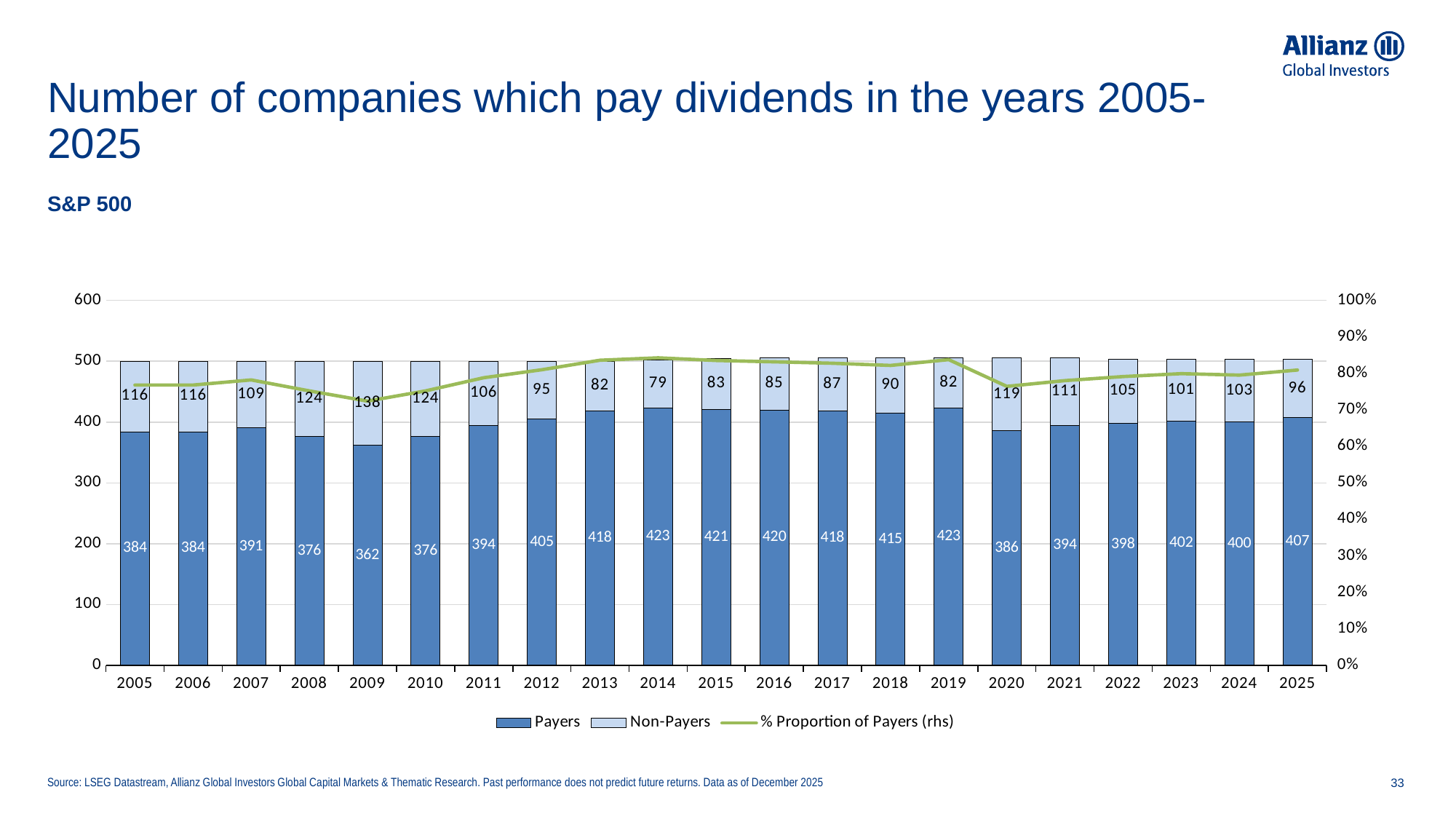
How many years are shown on the x axis? 21 Which year has the lowest Non-Payers value? 2014 Which is larger, the Payers value for 2012 or for 2021? 2012 Which year has the highest Non-Payers value? 2009 What is the total of the stacked bar (Payers plus Non-Payers) for 2025? 503 How many Payers are shown for 2025? 407 Is the % Proportion of Payers for 2009 greater or less than 80%? less How many companies were Payers in 2009? 362 Which year has the lowest Payers value? 2009 What is the difference between the Payers values for 2014 and 2020? 37 What is the Non-Payers value for 2020? 119 How many series does the legend list? 3